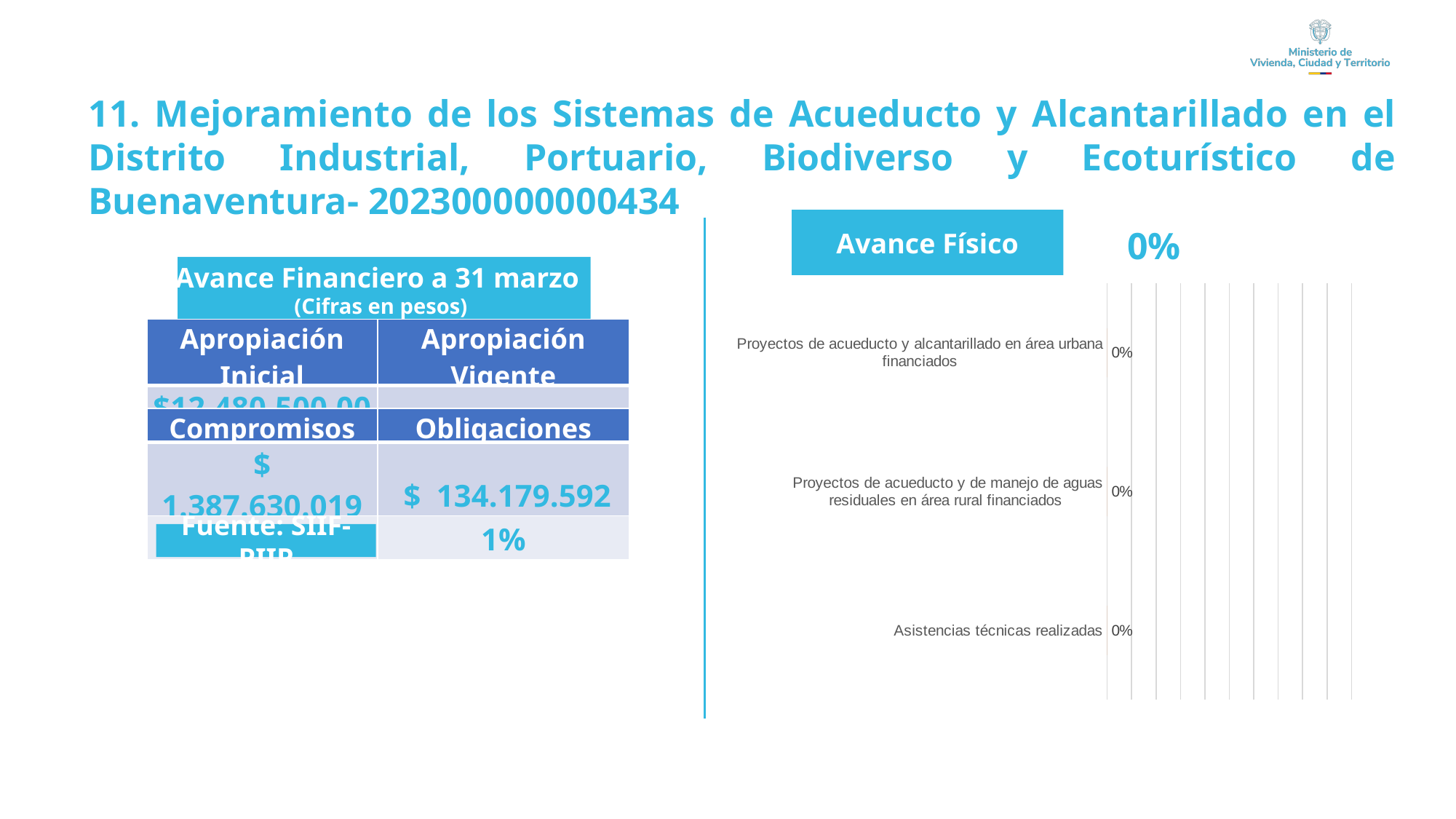
In the Avance Físico chart, what value is shown for 'Proyectos de acueducto y alcantarillado en área urbana financiados'? 0% What is the title of the chart on the right side of the slide? Avance Físico In the Avance Físico chart, what value is shown for 'Proyectos de acueducto y de manejo de aguas residuales en área rural financiados'? 0% What is the value for 'Asistencias técnicas realizadas' in the Avance Físico chart? 0% Do all three categories in the Avance Físico chart show the same value? Yes How many categories are shown in the Avance Físico chart? 3 What is the difference between the values for 'Asistencias técnicas realizadas' and 'Proyectos de acueducto y alcantarillado en área urbana financiados' in the Avance Físico chart? 0% What overall percentage is displayed next to the Avance Físico chart title? 0%